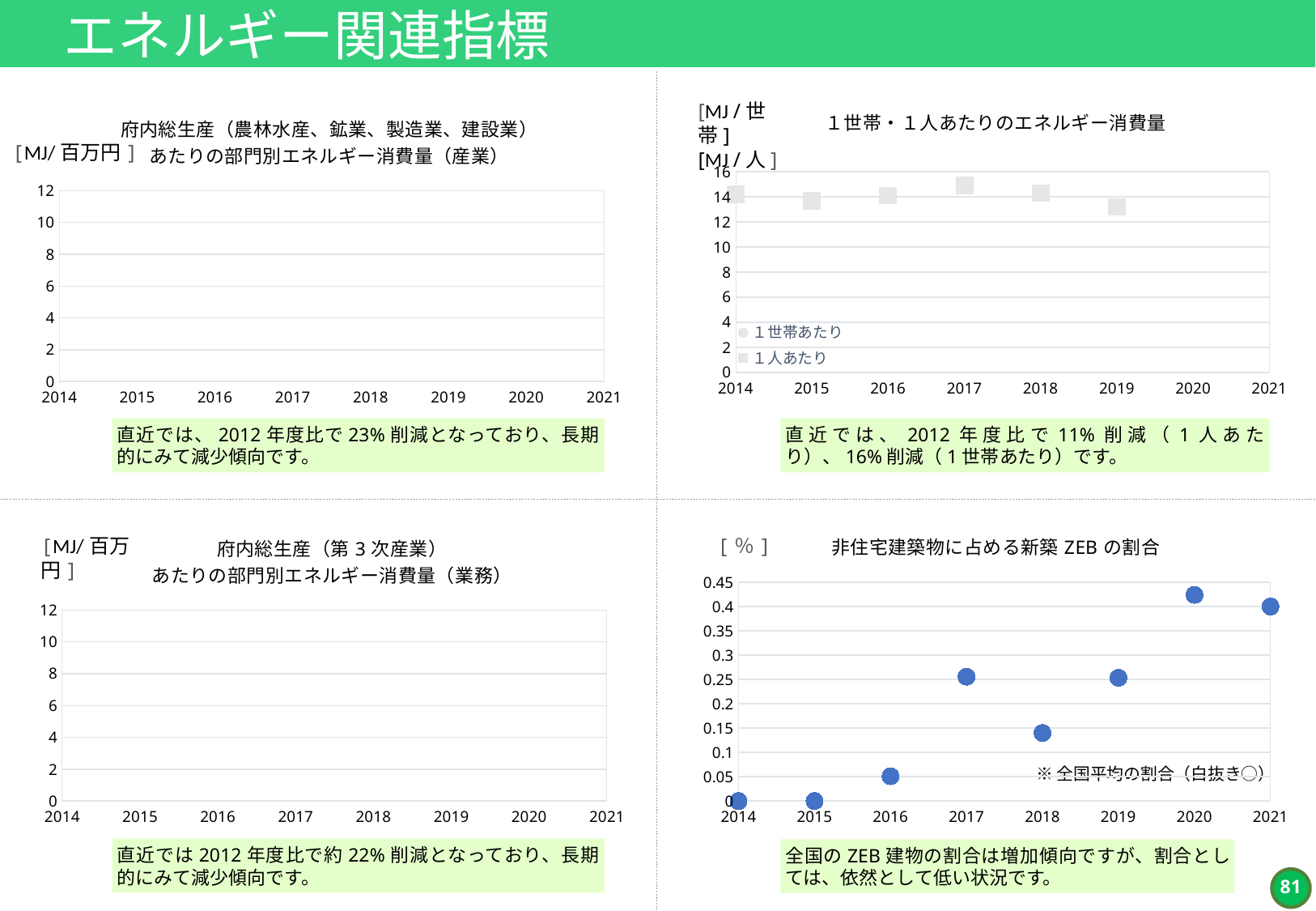
How many series does the legend of the top-right chart (1世帯・1人あたりのエネルギー消費量) list? 2 In the bottom-right chart (非住宅建築物に占める新築ZEBの割合), is the value for 2017 greater or less than 0.2? greater In the bottom-right chart (非住宅建築物に占める新築ZEBの割合), do the values generally rise or fall from 2014 to 2021? rise In the top-right chart (1世帯・1人あたりのエネルギー消費量), is the 1人あたり value for 2019 greater or less than 14? less What are the two legend entries in the top-right chart (1世帯・1人あたりのエネルギー消費量)? 1世帯あたり and 1人あたり In the top-right chart (1世帯・1人あたりのエネルギー消費量), is the 1人あたり value for 2017 greater or less than 14? greater What kind of chart is the bottom-right chart titled 非住宅建築物に占める新築ZEBの割合? scatter chart In the bottom-right chart (非住宅建築物に占める新築ZEBの割合), which year has the highest value? 2020 In the bottom-right chart (非住宅建築物に占める新築ZEBの割合), which year has the larger value, 2018 or 2020? 2020 In the bottom-right chart (非住宅建築物に占める新築ZEBの割合), how many data points are plotted? 8